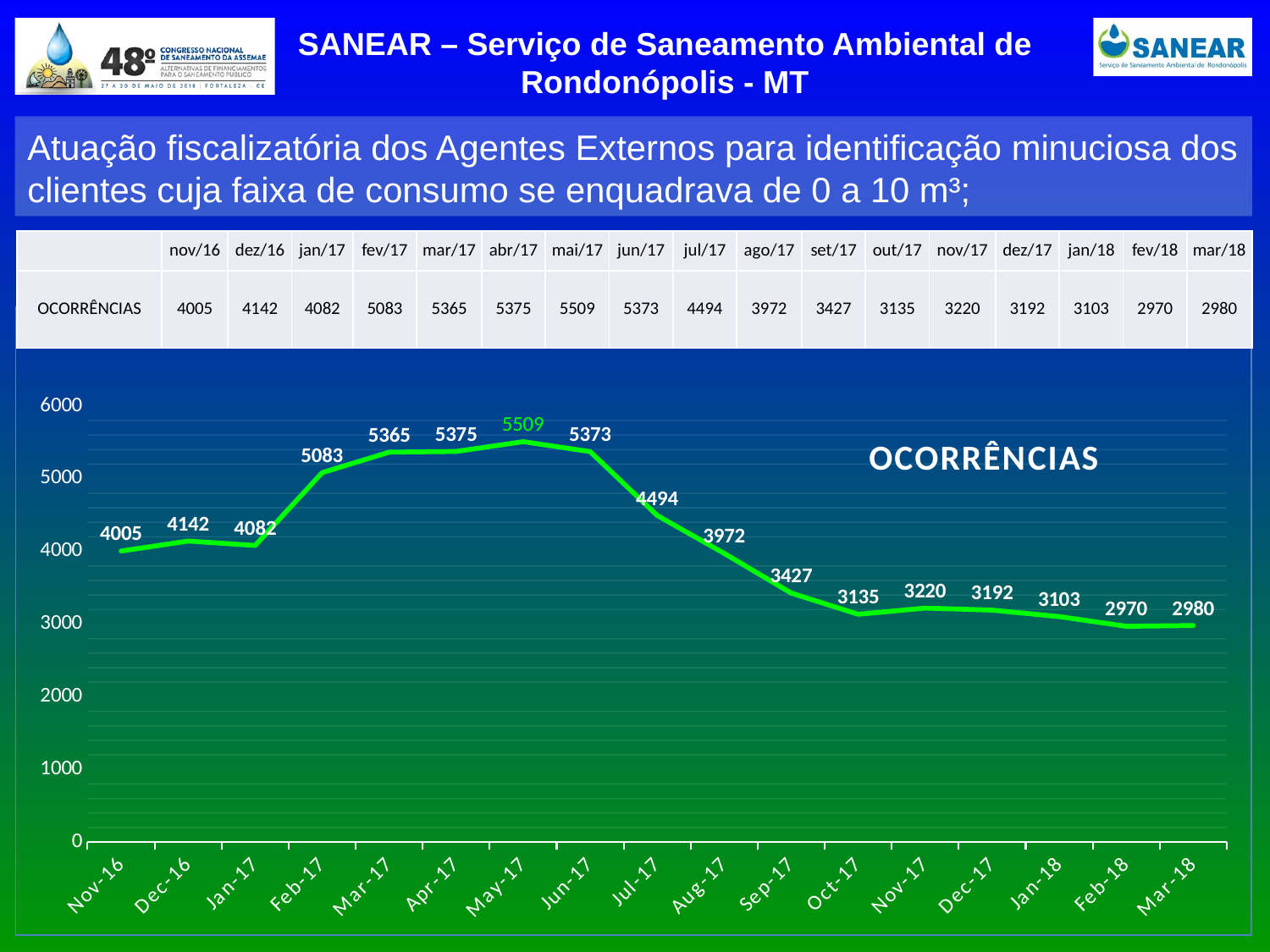
What kind of chart is used to show OCORRÊNCIAS? line chart How many months are plotted in the OCORRÊNCIAS chart? 17 What is the difference between the values for May-17 and Mar-18 in the OCORRÊNCIAS chart? 2529 What is the value for Nov-16 in the OCORRÊNCIAS chart? 4005 Is the value for Sep-17 in the OCORRÊNCIAS chart greater or less than 4000? less Which is larger in the OCORRÊNCIAS chart, the value for Dec-16 or the value for Jan-17? Dec-16 What is the difference between the values for Jul-17 and Aug-17 in the OCORRÊNCIAS chart? 522 Which month has the highest value in the OCORRÊNCIAS chart? May-17 What is the value for May-17 in the OCORRÊNCIAS chart? 5509 What is the value for Mar-18 in the OCORRÊNCIAS chart? 2980 Do the values in the OCORRÊNCIAS chart rise or fall from Jun-17 to Oct-17? fall Which month has the lowest value in the OCORRÊNCIAS chart? Feb-18